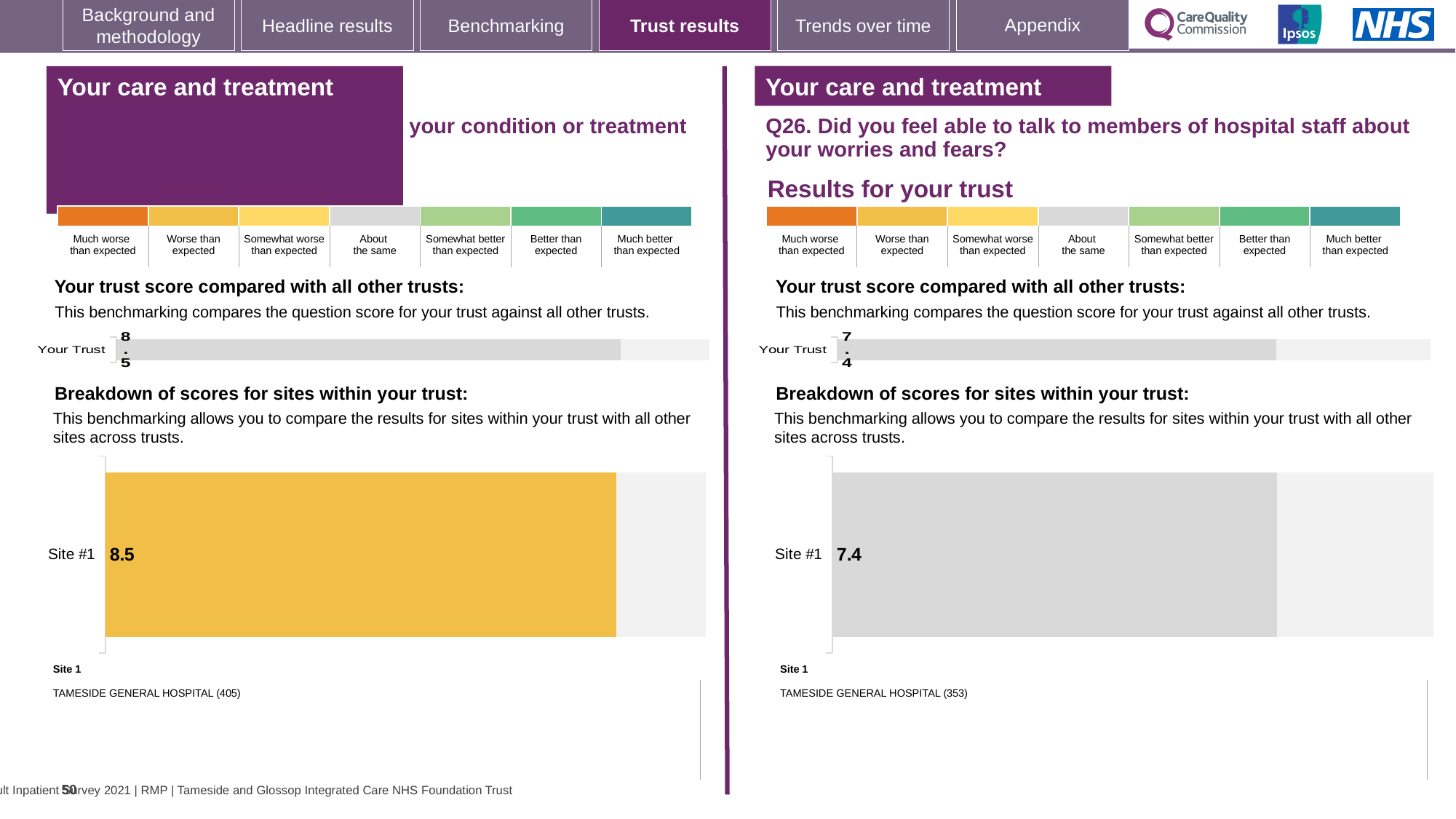
On the right half of the slide (Q26), what is the score shown for Your Trust? 7.4 Is the Site #1 value on the left breakdown chart greater or less than the Site #1 value on the right breakdown chart? greater What is the difference between the Site #1 score on the left chart and the Site #1 score on the right chart? 1.1 In the left 'Breakdown of scores for sites within your trust' chart, what is the value for Site #1? 8.5 On the left half of the slide, what is the score shown for Your Trust? 8.5 What kind of chart is used to show the Site #1 score on the right half of the slide? Bar chart Which site name is listed under Site 1 on the right half of the slide (Q26)? TAMESIDE GENERAL HOSPITAL (353) How many sites are shown in the left 'Breakdown of scores for sites within your trust' chart? 1 What colour is the Site #1 bar in the left breakdown chart? Yellow Which is larger: the Your Trust score on the left half of the slide or the Your Trust score on the right half (Q26)? Left half (8.5) In the right 'Breakdown of scores for sites within your trust' chart (Q26), what is the value for Site #1? 7.4